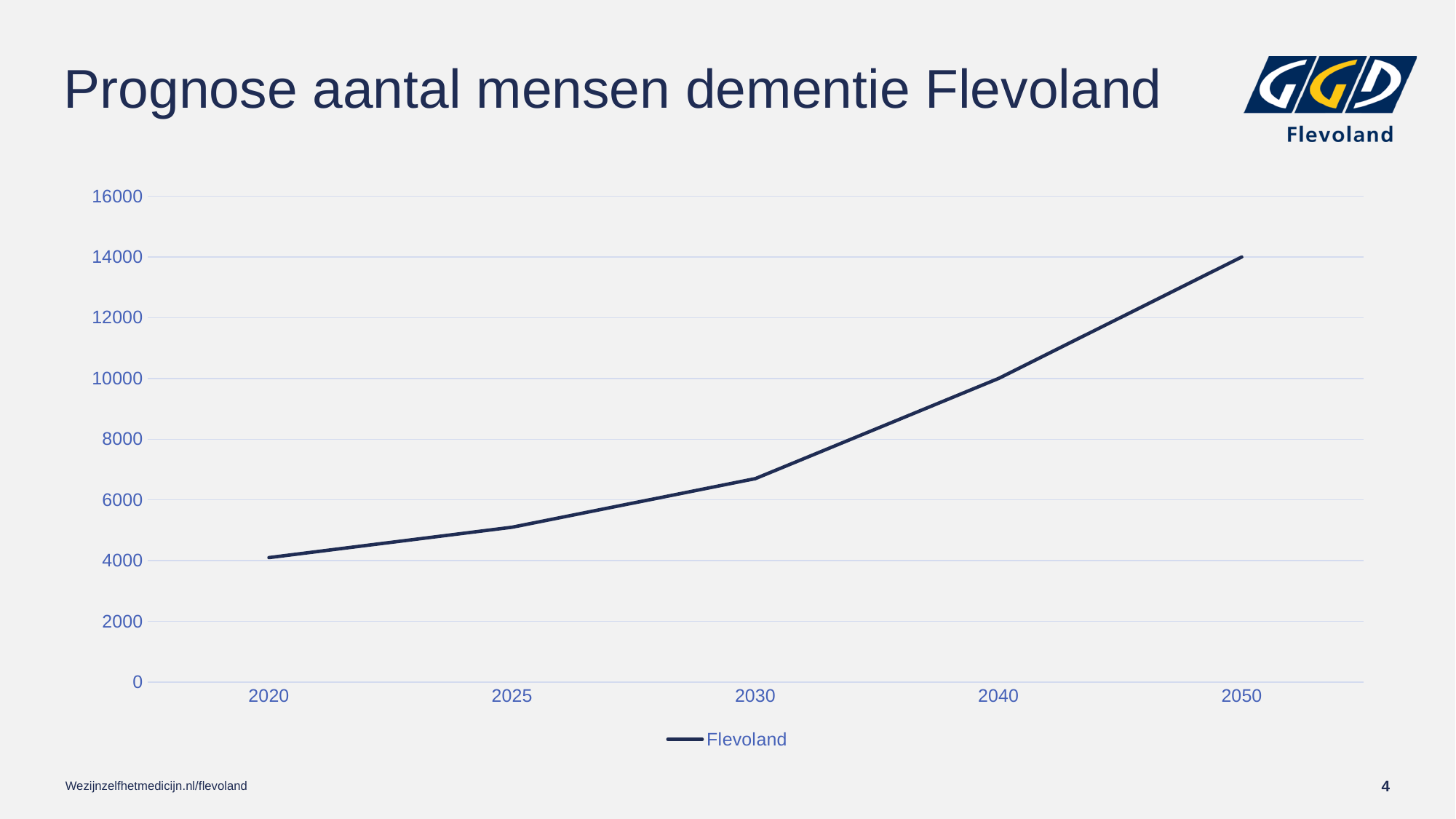
Is the value for 2050 greater or less than 12000? greater What is the name of the series shown in the legend? Flevoland How many years are labelled on the x axis? 5 Which year has the lowest value? 2020 What kind of chart is shown on the slide? line chart Which is larger, the value for 2025 or the value for 2040? 2040 Is the value for 2030 greater or less than 6000? greater Do the values rise or fall from 2020 to 2050? rise How many series does the legend list? 1 Is the value for 2020 greater or less than 6000? less Which year has the highest value? 2050 What is the title of the chart on the slide? Prognose aantal mensen dementie Flevoland